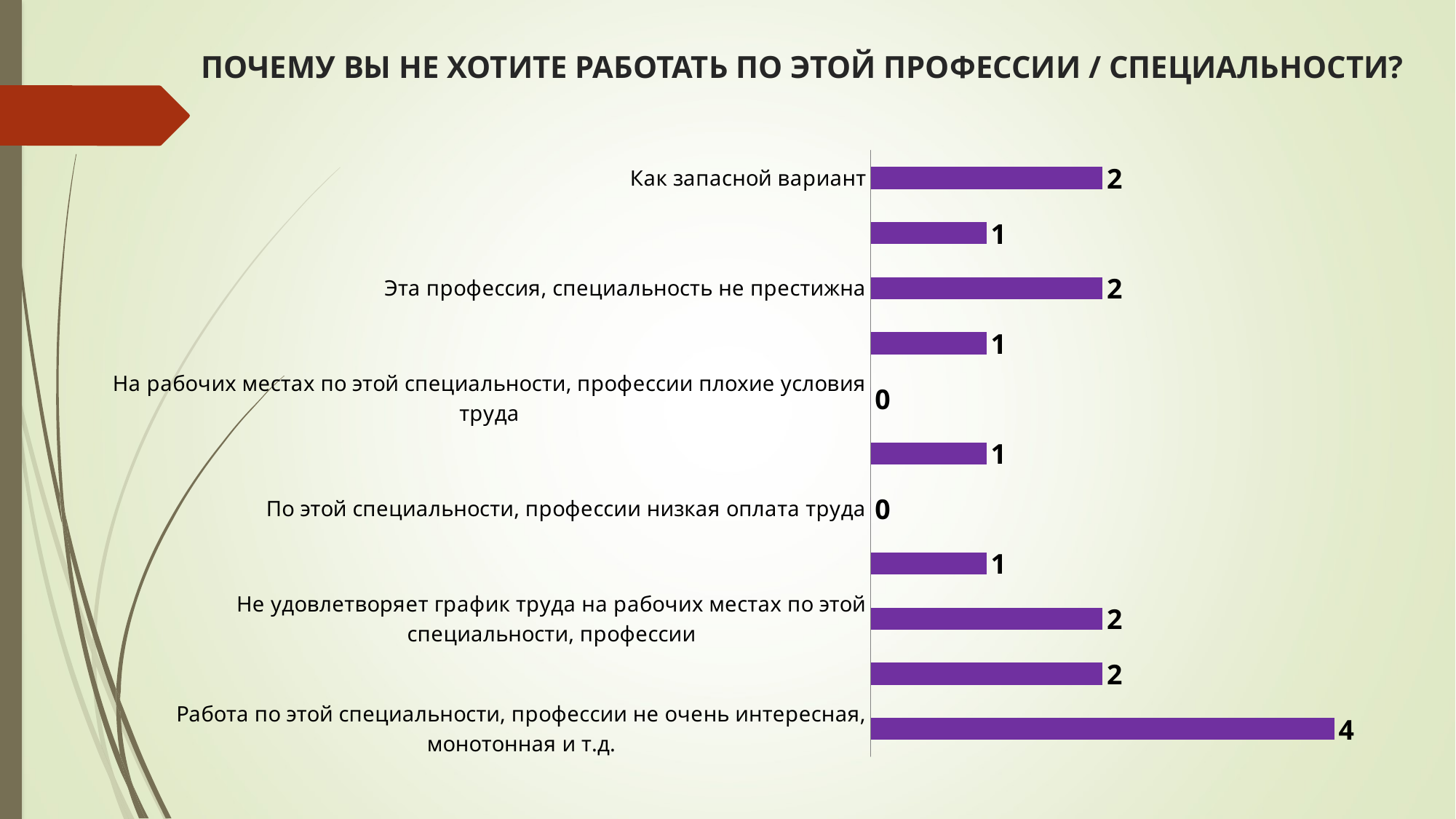
What is the value for "По этой специальности, профессии низкая оплата труда"? 0 What is the title of the slide? ПОЧЕМУ ВЫ НЕ ХОТИТЕ РАБОТАТЬ ПО ЭТОЙ ПРОФЕССИИ / СПЕЦИАЛЬНОСТИ? What is the value for "Работа по этой специальности, профессии не очень интересная, монотонная и т.д."? 4 What is the value for "Не удовлетворяет график труда на рабочих местах по этой специальности, профессии"? 2 What is the value for "Как запасной вариант"? 2 How many data labels are shown on the chart? 11 What type of chart is shown on the slide? bar chart What is the value for "На рабочих местах по этой специальности, профессии плохие условия труда"? 0 Which is larger: the value for "Эта профессия, специальность не престижна" or the value for "По этой специальности, профессии низкая оплата труда"? Эта профессия, специальность не престижна Which category has the highest value? Работа по этой специальности, профессии не очень интересная, монотонная и т.д. What is the value for "Эта профессия, специальность не престижна"? 2 What is the difference between the value for "Работа по этой специальности, профессии не очень интересная, монотонная и т.д." and the value for "Как запасной вариант"? 2